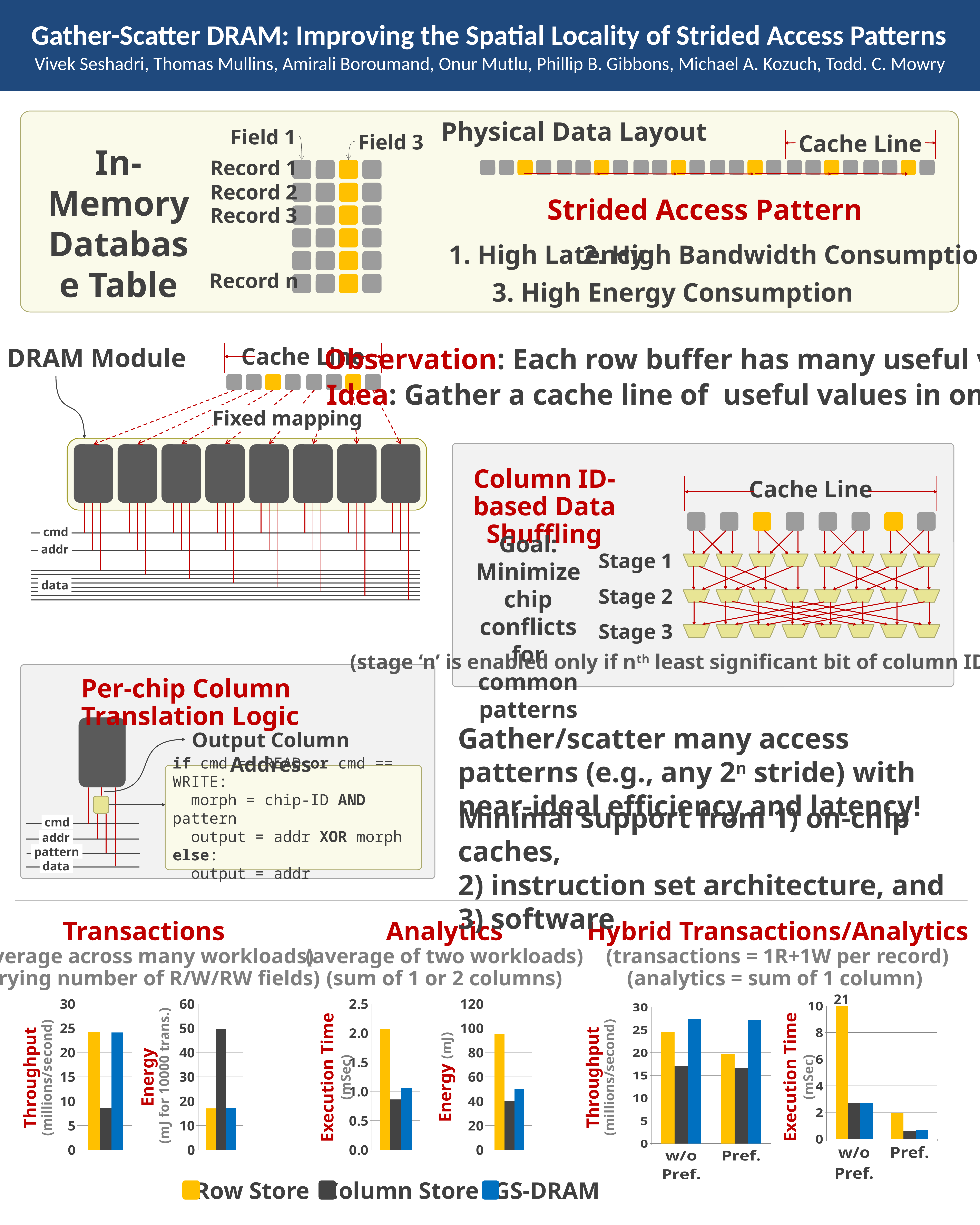
In the Transactions Throughput chart, which series has the lowest throughput? Column Store What kind of chart is the Transactions Throughput chart? bar chart In the Analytics Energy chart, which series has the highest energy? Row Store In the Hybrid Transactions/Analytics Execution Time chart, what is the value for Row Store without prefetching (w/o Pref.)? 21 In the Analytics Execution Time chart, is the value for Row Store greater or less than 2.0? greater In the Transactions Energy chart, which series has the highest energy? Column Store What colour represents GS-DRAM in the legend? blue How many series does the shared legend at the bottom of the slide list? 3 In the Analytics Energy chart, is the value for Column Store greater or less than 60? less In the Transactions Energy chart, is the value for Column Store greater or less than 40? greater In the Hybrid Transactions/Analytics Throughput chart, which series is larger for w/o Pref.: Row Store or Column Store? Row Store How many categories are shown on the x axis of the Hybrid Transactions/Analytics Throughput chart? 2